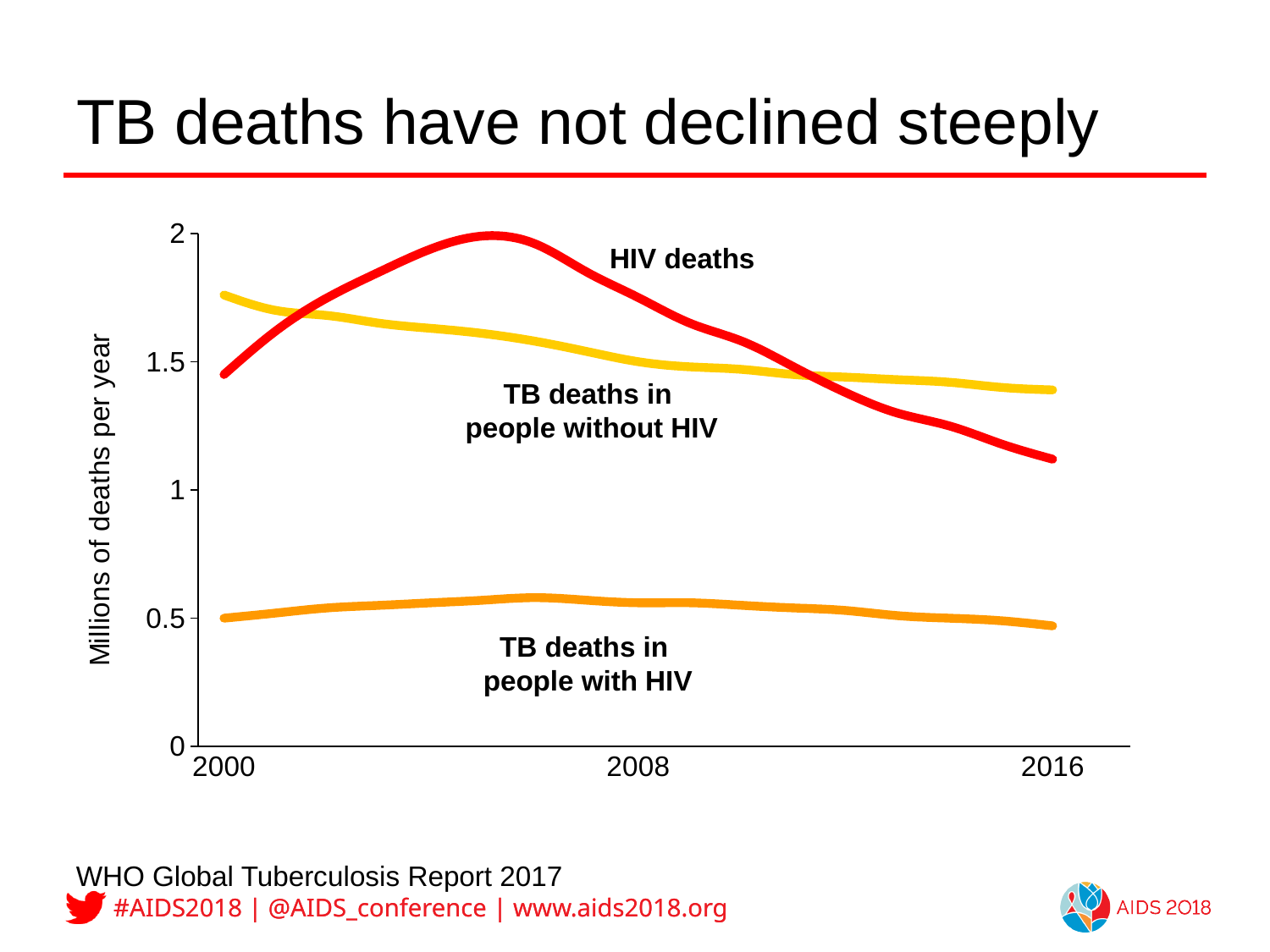
Which series has the highest value in 2008? HIV deaths In 2016, which is larger: HIV deaths or TB deaths in people without HIV? TB deaths in people without HIV How many data series are plotted on the chart? 3 Is the value for TB deaths in people without HIV in 2016 greater or less than 1.5? less Is the value for HIV deaths in 2016 greater or less than 1? greater Do TB deaths in people without HIV rise or fall from 2000 to 2016? fall Is the value for TB deaths in people without HIV in 2000 greater or less than 1.5? greater In 2000, which is larger: HIV deaths or TB deaths in people without HIV? TB deaths in people without HIV What is the label of the vertical axis? Millions of deaths per year What kind of chart is shown on the slide? line chart Which series has the lowest values across the whole period? TB deaths in people with HIV What is the title of the slide containing the chart? TB deaths have not declined steeply